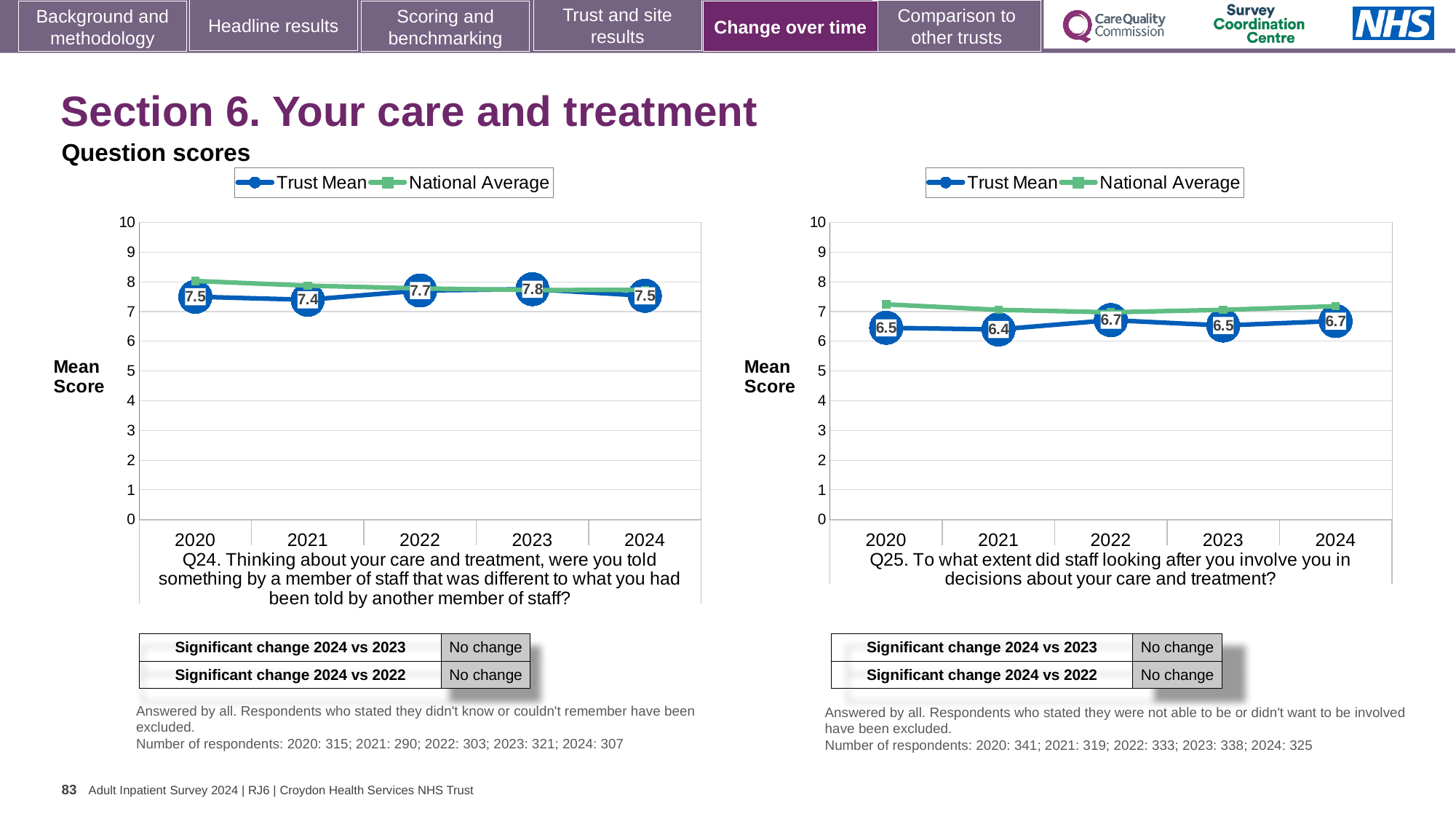
In the Q24 chart, is the National Average value for 2022 greater or less than 7? greater In the Q25 chart, what is the Trust Mean score for 2021? 6.4 What kind of chart is the Q25 chart? line chart How many series does the legend of the Q24 chart list? 2 In the Q25 chart, does the Trust Mean score rise or fall from 2021 to 2022? rise In the Q24 chart, what is the difference between the Trust Mean scores for 2023 and 2021? 0.4 In the Q25 chart, which year has the lowest Trust Mean score? 2021 How many years are plotted on the x axis of the Q25 chart? 5 In the Q24 chart, what is the Trust Mean score for 2023? 7.8 In the Q24 chart, which year has the highest Trust Mean score? 2023 In the Q25 chart, is the Trust Mean score for 2022 higher or lower than for 2023? higher In the Q24 chart, which year has the lowest Trust Mean score? 2021